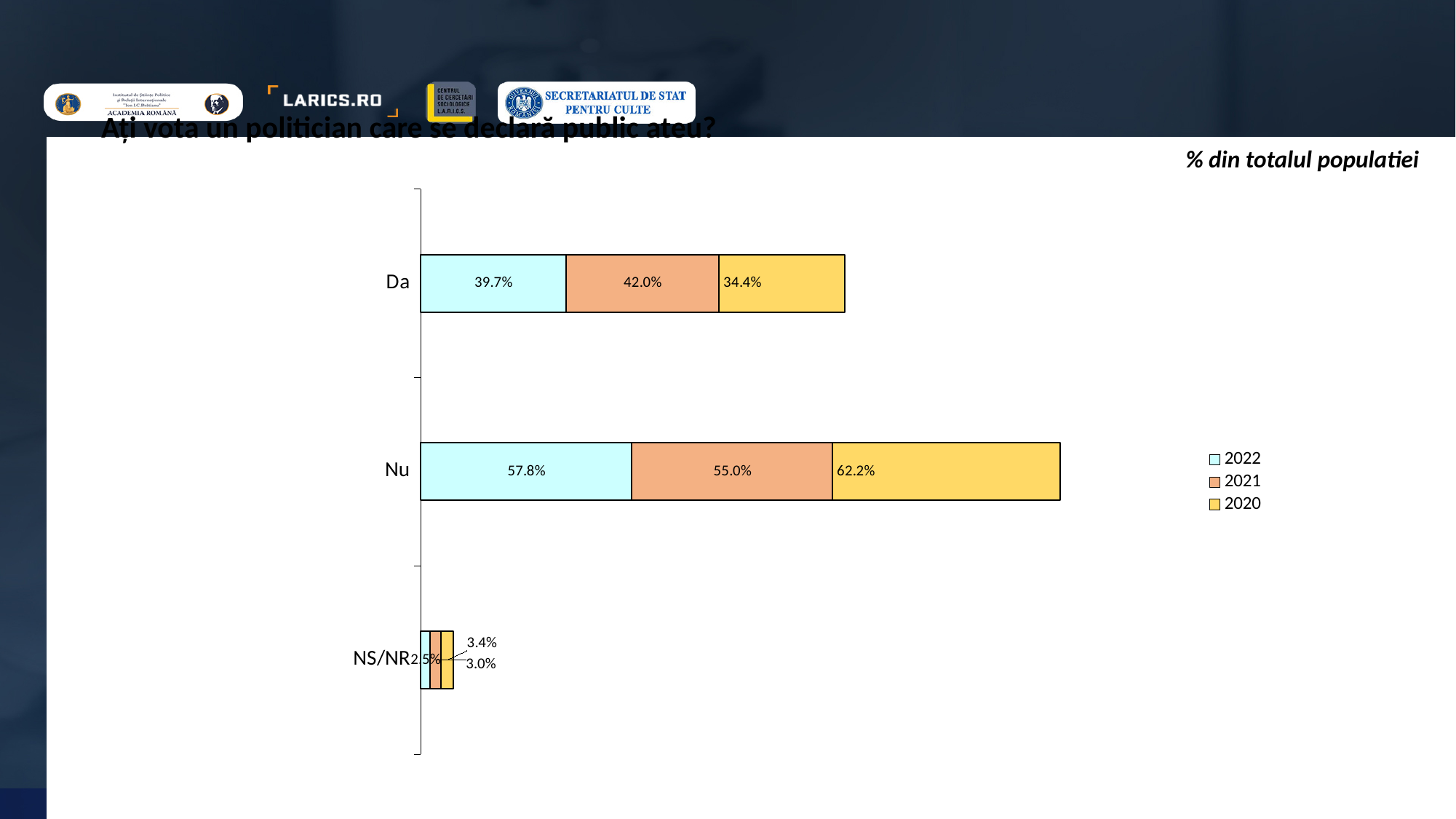
What is the value for Da in the 2022 series? 39.7% For Da, which year has the larger value, 2021 or 2020? 2021 What is the value for Nu in the 2020 series? 62.2% How many series does the legend list? 3 What is the value for Da in the 2021 series? 42.0% What is the difference between the 2022 values for Nu and Da? 18.1 percentage points What is the value for Nu in the 2021 series? 55.0% What is the total of the stacked bar for Da? 116.1% Which category has the highest value in the 2022 series? Nu How many categories are shown on the chart? 3 What kind of chart is shown on the slide? Stacked bar chart Which category has the lowest value in the 2020 series? NS/NR